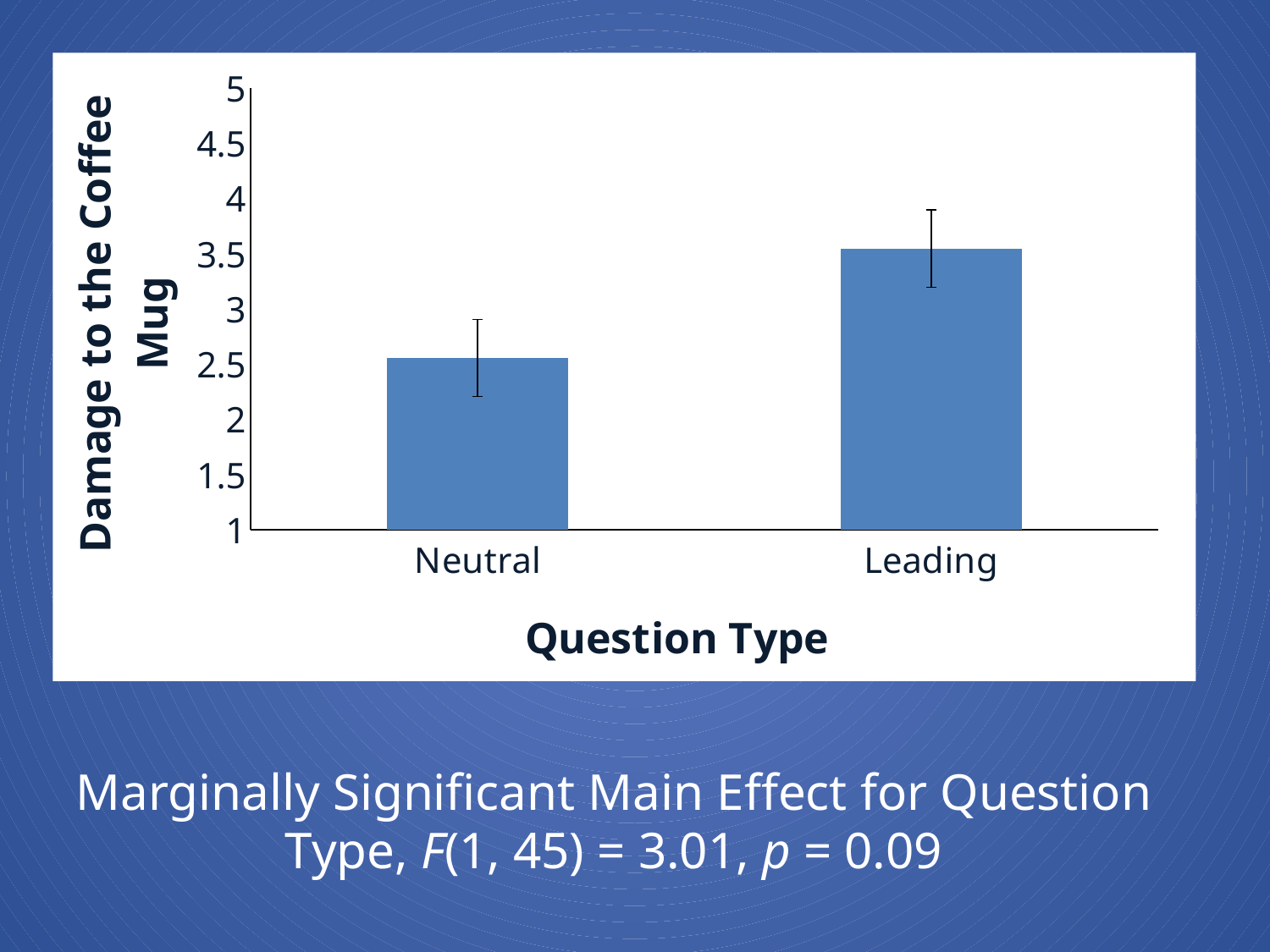
How many question types are plotted on the x axis? 2 Which is larger, the value for Neutral or the value for Leading? Leading Is the value for Leading greater or less than 4? less Which question type has the lowest damage to the coffee mug? Neutral Is the value for Neutral greater or less than 2? greater What kind of chart is shown on the slide? bar chart Is the value for Leading greater or less than 3? greater Do the values rise or fall from Neutral to Leading along the x axis? rise What is the label of the y axis? Damage to the Coffee Mug Which question type has the highest damage to the coffee mug? Leading What is the label of the x axis? Question Type